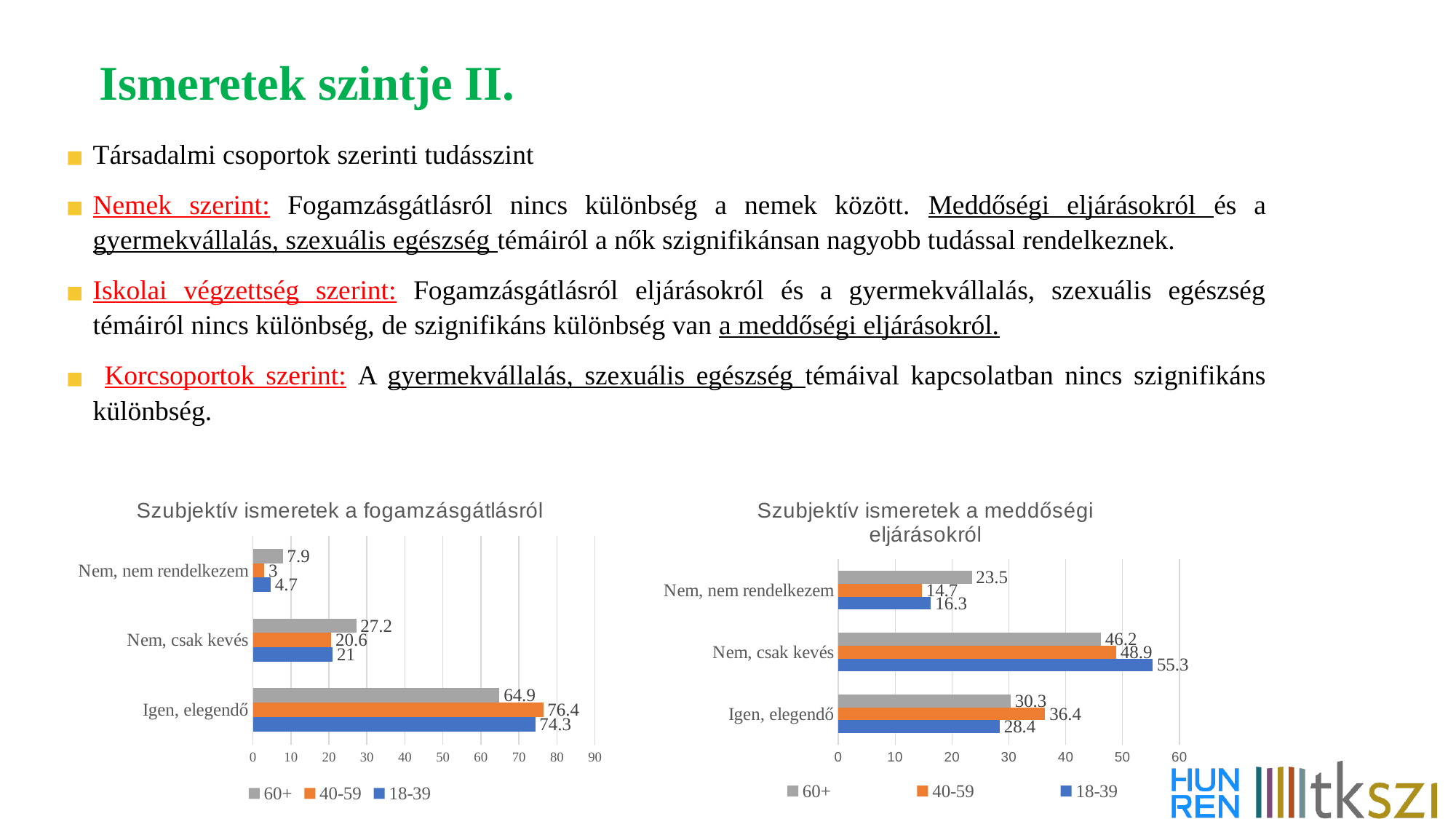
In the chart 'Szubjektív ismeretek a fogamzásgátlásról', which age group has the highest value in the 'Igen, elegendő' category? 40-59 How many categories are shown in the chart 'Szubjektív ismeretek a meddőségi eljárásokról'? 3 In the chart 'Szubjektív ismeretek a fogamzásgátlásról', what is the value for the 60+ series in the 'Nem, nem rendelkezem' category? 7.9 What kind of chart is 'Szubjektív ismeretek a fogamzásgátlásról'? Bar chart In the chart 'Szubjektív ismeretek a meddőségi eljárásokról', what is the value for the 18-39 series in the 'Nem, csak kevés' category? 55.3 In the chart 'Szubjektív ismeretek a meddőségi eljárásokról', what is the difference between the 18-39 and 60+ values in the 'Nem, csak kevés' category? 9.1 In the chart 'Szubjektív ismeretek a meddőségi eljárásokról', what is the value for the 40-59 series in the 'Igen, elegendő' category? 36.4 In the chart 'Szubjektív ismeretek a fogamzásgátlásról', what is the difference between the 60+ and 40-59 values in the 'Nem, csak kevés' category? 6.6 In the chart 'Szubjektív ismeretek a fogamzásgátlásról', what is the value for the 40-59 series in the 'Igen, elegendő' category? 76.4 How many series does the legend list in the chart 'Szubjektív ismeretek a fogamzásgátlásról'? 3 In the chart 'Szubjektív ismeretek a meddőségi eljárásokról', which is larger in the 'Igen, elegendő' category: the 60+ value or the 18-39 value? 60+ In the chart 'Szubjektív ismeretek a meddőségi eljárásokról', which age group has the lowest value in the 'Nem, nem rendelkezem' category? 40-59